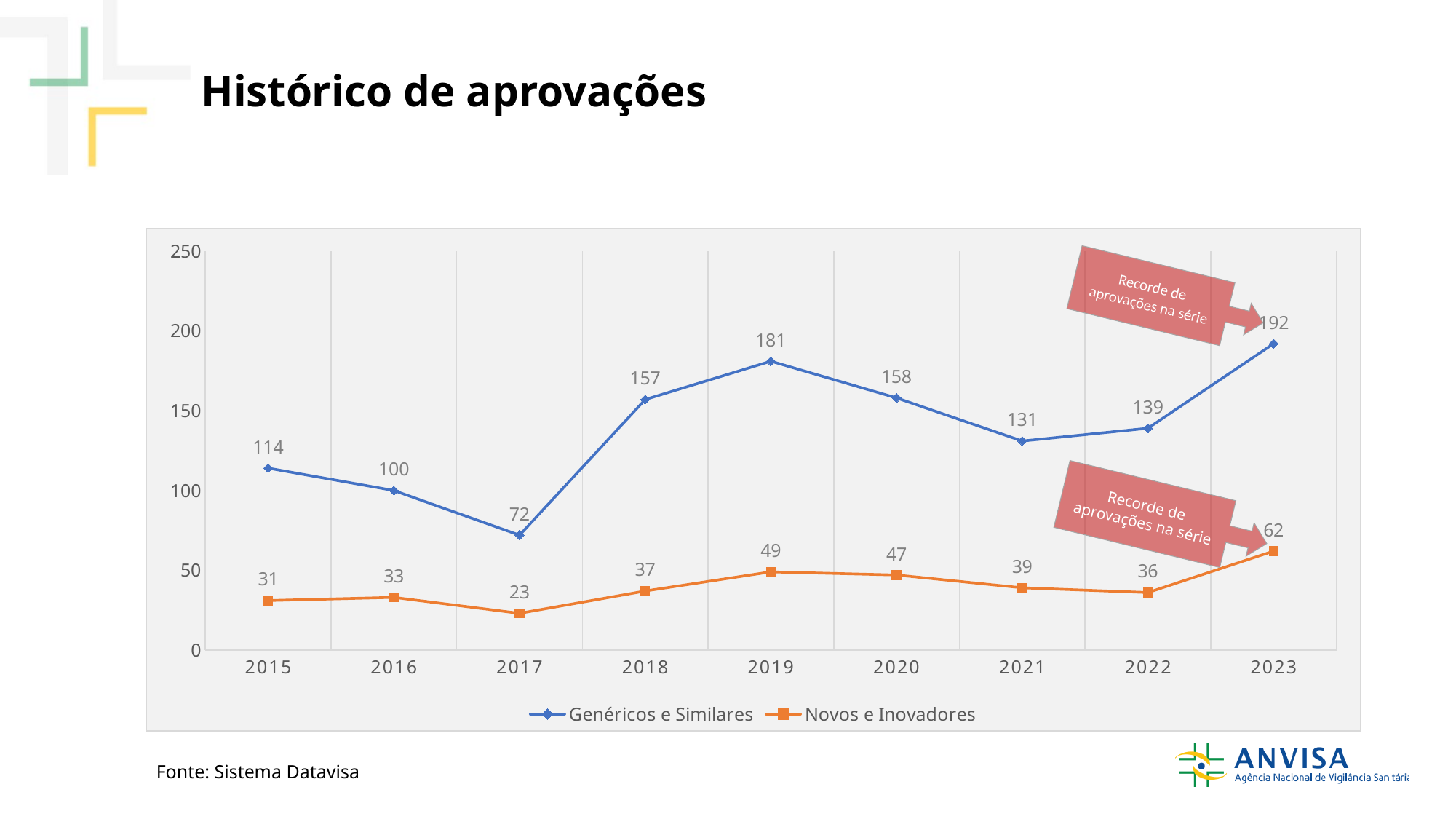
In which year is the Novos e Inovadores series highest? 2023 How many series does the legend list? 2 Did the Novos e Inovadores series rise or fall from 2022 to 2023? Rise What is the difference between Genéricos e Similares and Novos e Inovadores in 2023? 130 What is the value for Genéricos e Similares in 2019? 181 What is the title of the slide? Histórico de aprovações What kind of chart is shown on the slide? Line chart What is the value for Novos e Inovadores in 2017? 23 Which is larger for Genéricos e Similares: the value in 2018 or the value in 2020? 2020 In which year is the Genéricos e Similares series lowest? 2017 What is the value for Genéricos e Similares in 2023? 192 How many years are shown on the x axis? 9